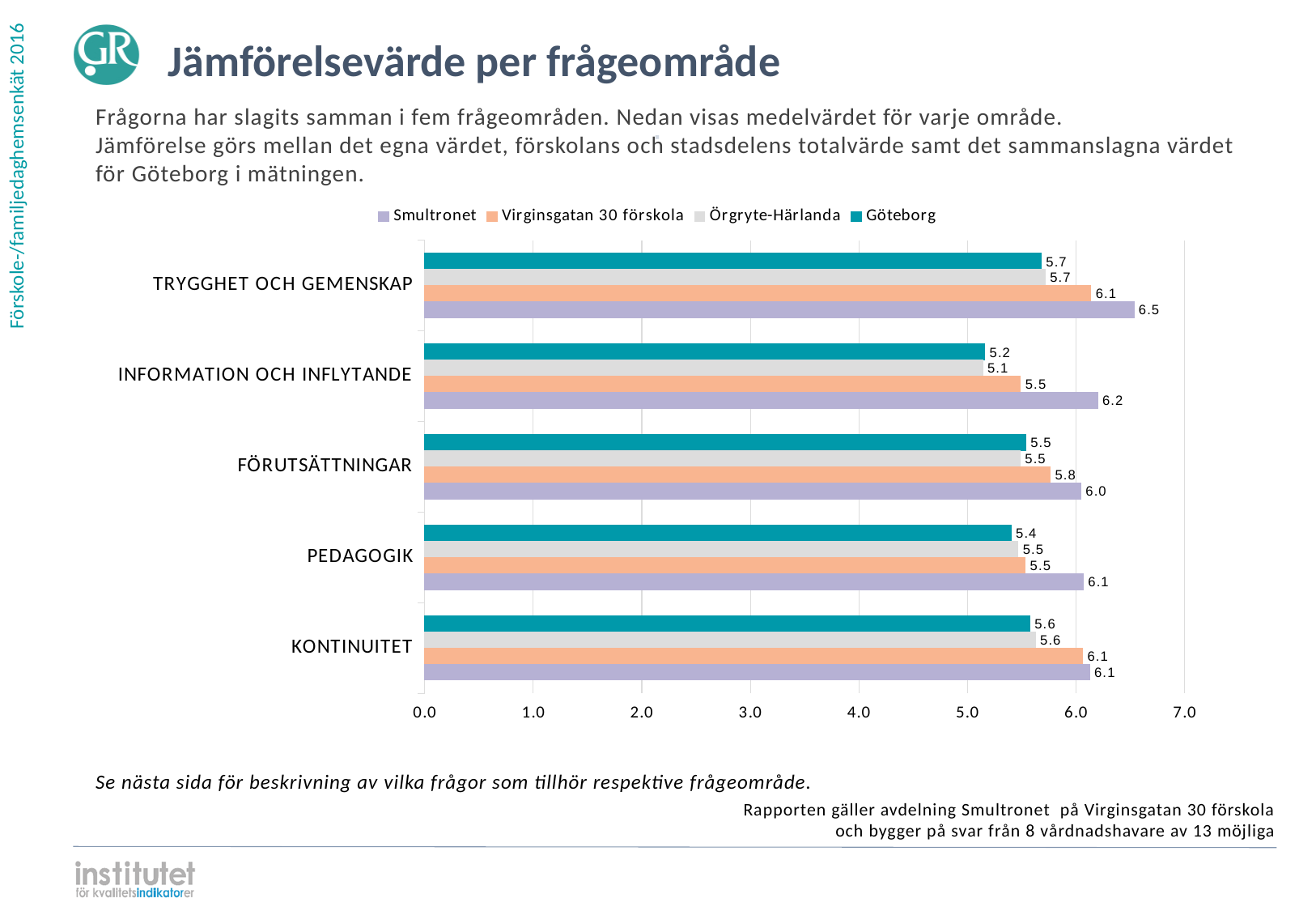
In which category does Smultronet have its highest value? TRYGGHET OCH GEMENSKAP What is the value for Örgryte-Härlanda in PEDAGOGIK? 5.5 How many question areas (categories) are shown on the chart? 5 What is the maximum value shown on the horizontal axis? 7.0 Which is larger in KONTINUITET: Virginsgatan 30 förskola or Örgryte-Härlanda? Virginsgatan 30 förskola What is the value for Göteborg in INFORMATION OCH INFLYTANDE? 5.2 What is the difference between Smultronet and Göteborg in INFORMATION OCH INFLYTANDE? 1.0 How many series does the legend list? 4 What is the value for Smultronet in TRYGGHET OCH GEMENSKAP? 6.5 What kind of chart is shown on the slide? Bar chart In which category does Göteborg have its lowest value? INFORMATION OCH INFLYTANDE What is the value for Virginsgatan 30 förskola in FÖRUTSÄTTNINGAR? 5.8